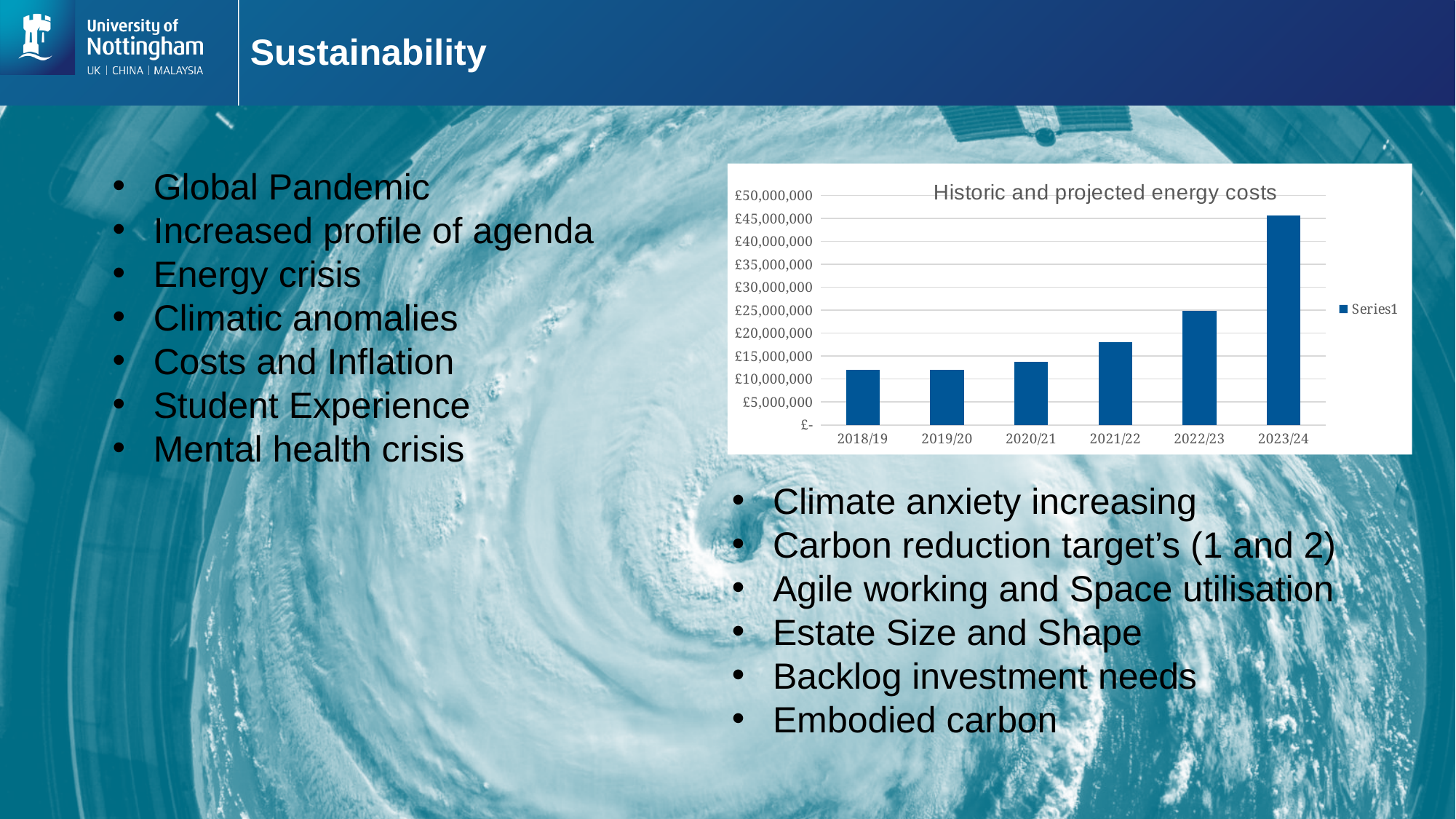
Is the value for 2022/23 greater or less than £20,000,000? greater Which is larger, the value for 2022/23 or the value for 2021/22? 2022/23 How many years (categories) are plotted on the x axis of the chart? 6 Do the energy costs generally rise or fall from 2018/19 to 2023/24? Rise Which year has the highest energy cost in the chart? 2023/24 How many series does the chart's legend list? 1 Is the value for 2021/22 greater or less than £20,000,000? less What is the title of the chart? Historic and projected energy costs Is the value for 2018/19 greater or less than £10,000,000? greater What type of chart is shown on the slide? Bar chart What is the name of the series shown in the chart's legend? Series1